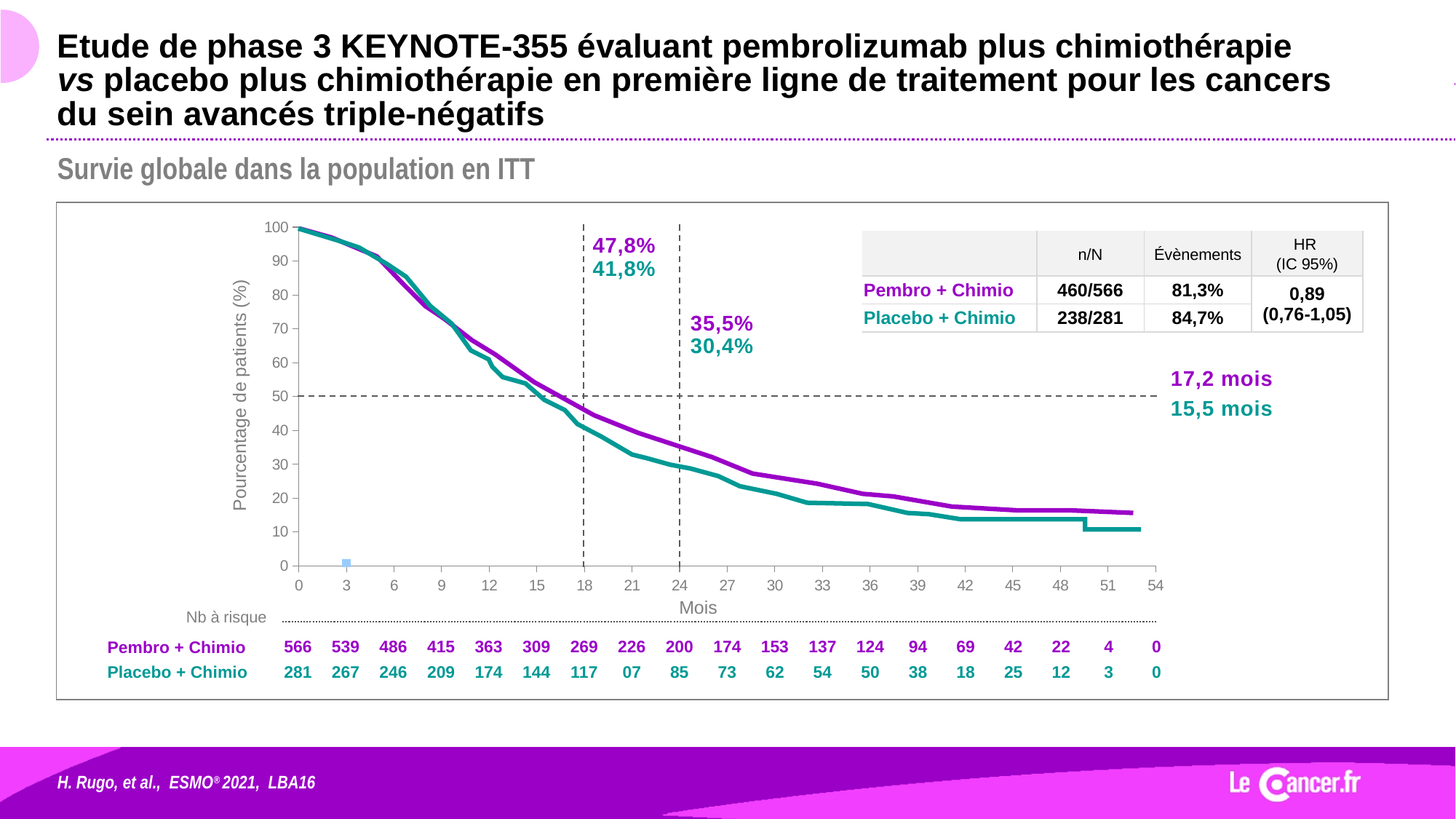
How many patients were at risk in the Pembro + Chimio arm at 12 months? 363 What is the label of the y axis? Pourcentage de patients (%) What kind of chart is shown on the slide? line chart What is the hazard ratio (HR) shown in the table? 0,89 Which arm has the higher survival rate at 18 months, Pembro + Chimio or Placebo + Chimio? Pembro + Chimio What is the overall survival rate at 24 months for the Placebo + Chimio arm? 30,4% What is the median overall survival for the Placebo + Chimio arm? 15,5 mois What is the overall survival rate at 24 months for the Pembro + Chimio arm? 35,5% What is the overall survival rate at 18 months for the Placebo + Chimio arm? 41,8% What is the overall survival rate at 18 months for the Pembro + Chimio arm? 47,8% What is the difference in survival rate at 24 months between Pembro + Chimio and Placebo + Chimio? 5,1% Do the survival curves rise or fall as months increase along the x axis? fall